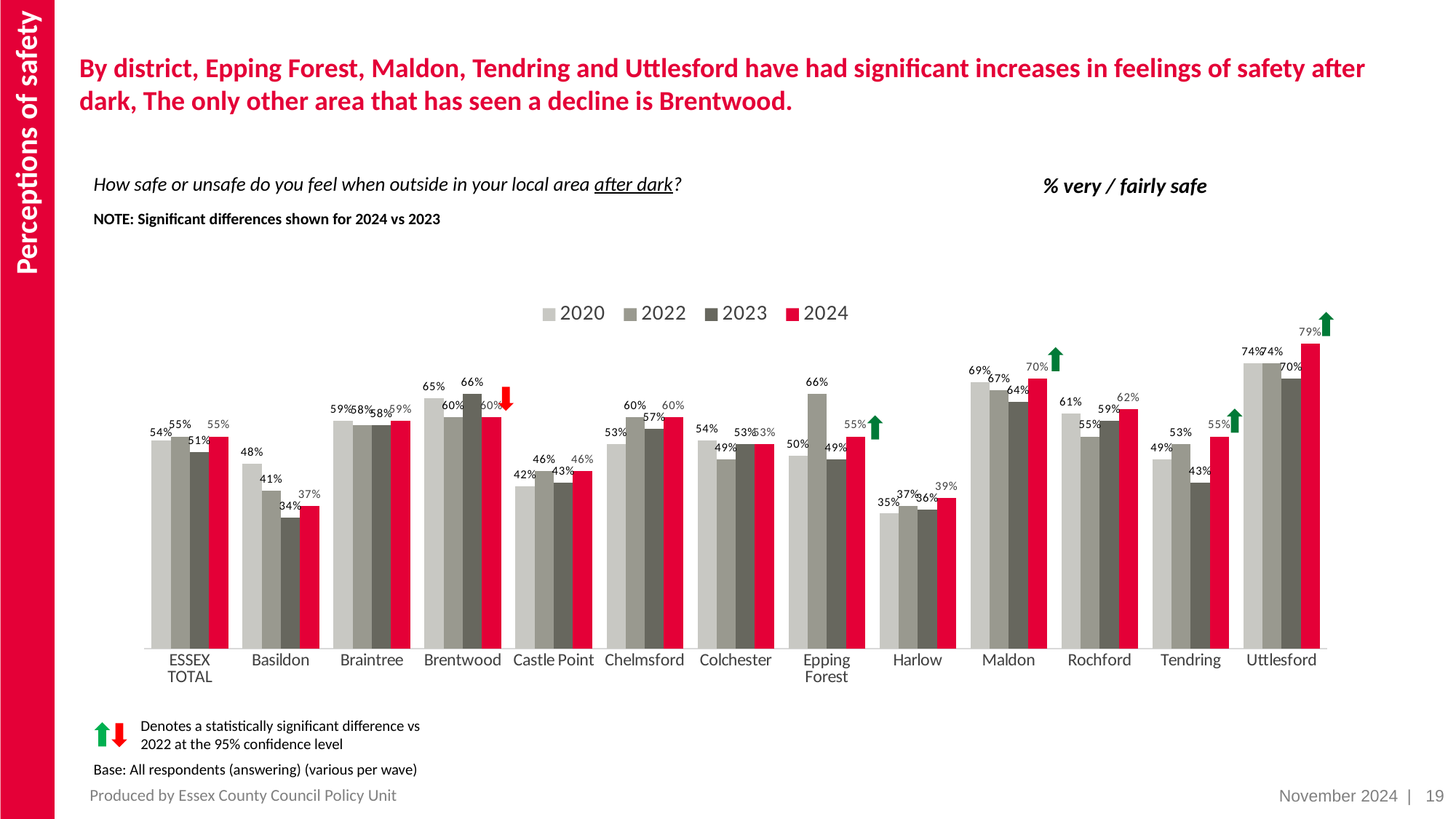
Which is larger for Brentwood, the 2023 value or the 2024 value? 2023 What is the 2020 value for ESSEX TOTAL? 54% Which colour represents the 2024 series in the legend? Red How many districts/categories are shown on the x axis? 13 What kind of chart is shown on the slide? Bar chart What is the 2023 value for Basildon? 34% What is the difference between the 2024 and 2023 values for Tendring? 12% How many series does the legend list? 4 Which district has the highest 2024 value? Uttlesford What is the 2022 value for Epping Forest? 66% Which district has the lowest 2024 value? Basildon What is the 2024 value for Uttlesford? 79%